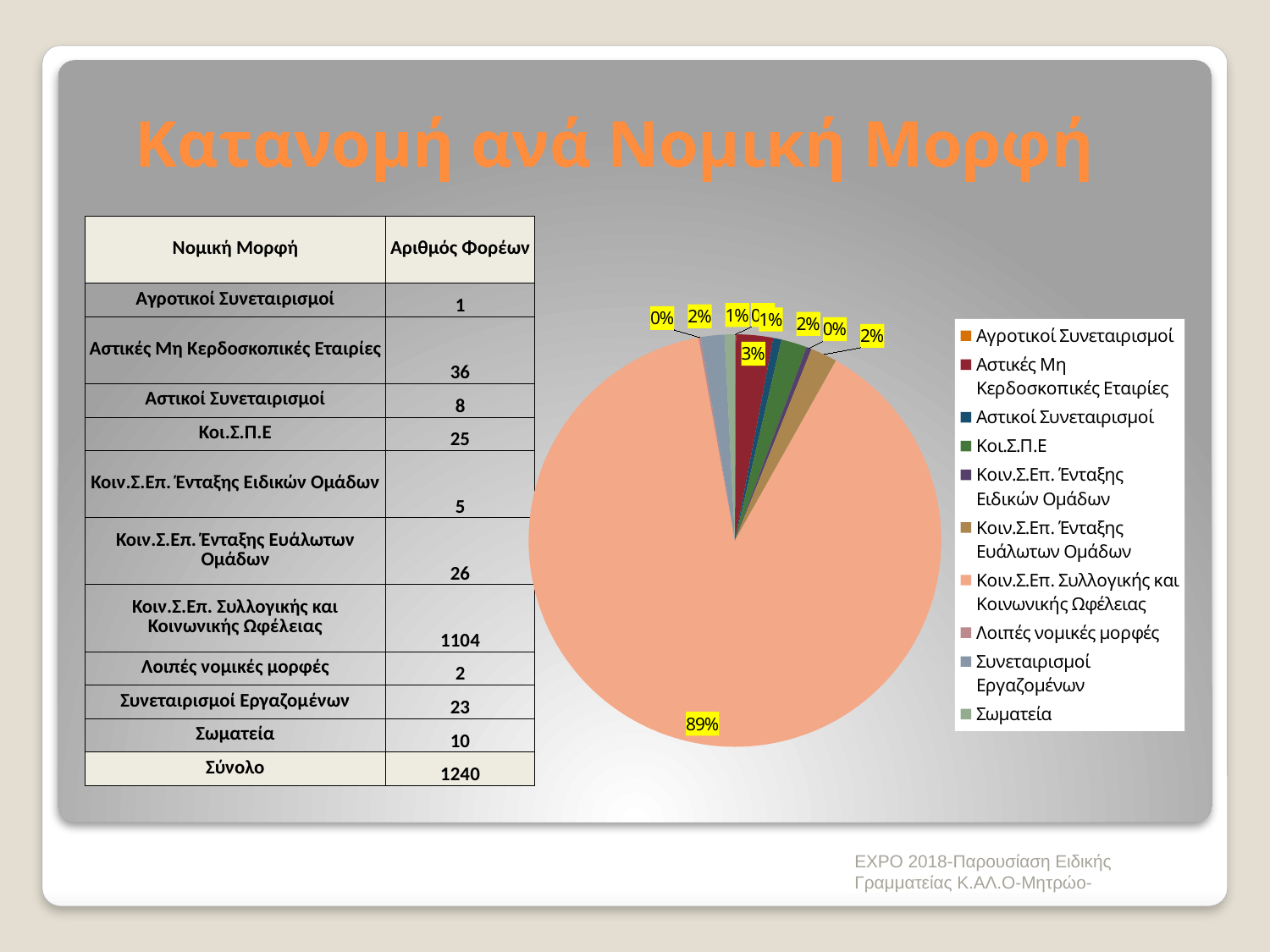
What share of the pie does Κοιν.Σ.Επ. Συλλογικής και Κοινωνικής Ωφέλειας represent? 89% What kind of chart is shown on the slide? pie chart What is the difference in percentage points between the Κοιν.Σ.Επ. Συλλογικής και Κοινωνικής Ωφέλειας slice and the Αστικές Μη Κερδοσκοπικές Εταιρίες slice? 86% Which legend entry is listed first in the pie chart legend? Αγροτικοί Συνεταιρισμοί What is the title of the chart slide? Κατανομή ανά Νομική Μορφή How many entries does the chart legend list? 10 What share of the pie does Αστικές Μη Κερδοσκοπικές Εταιρίες represent? 3% How many slices does the pie chart have? 10 Which category has the largest slice of the pie chart? Κοιν.Σ.Επ. Συλλογικής και Κοινωνικής Ωφέλειας Which slice is larger: Κοιν.Σ.Επ. Συλλογικής και Κοινωνικής Ωφέλειας or Αστικές Μη Κερδοσκοπικές Εταιρίες? Κοιν.Σ.Επ. Συλλογικής και Κοινωνικής Ωφέλειας